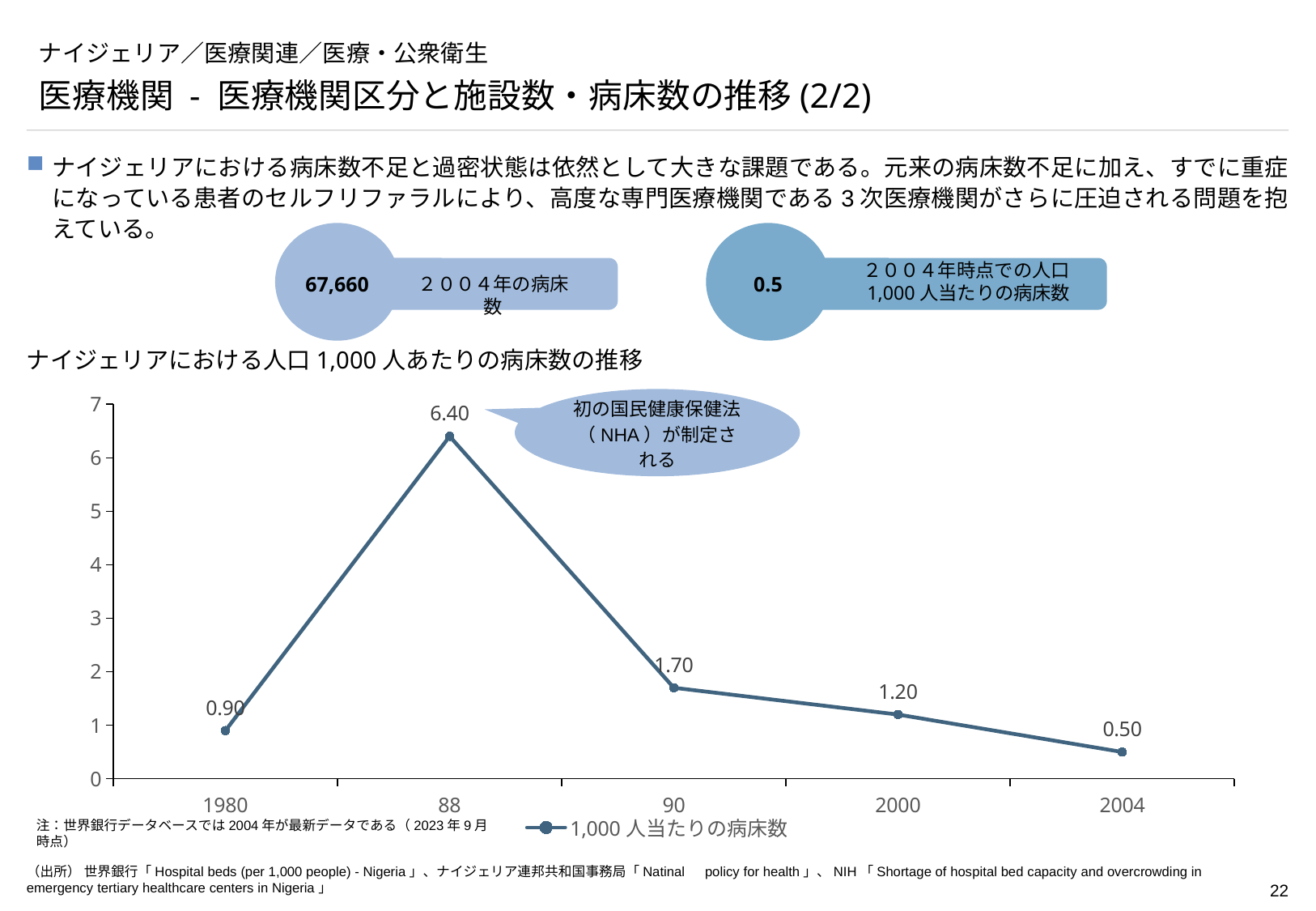
What is the difference between the values for 88 and 90? 4.70 Is the value for 90 greater or less than 2? less What is the value for 2004 in the chart? 0.50 Which year has the highest value in the chart? 88 Which year has the lowest value in the chart? 2004 What is the value for 88 in the chart? 6.40 How many data points are plotted in the chart? 5 What kind of chart is shown on the slide? line chart Do the values rise or fall from 88 to 2004? fall What is the value for 1980 in the chart? 0.90 What is the difference between the values for 2000 and 2004? 0.70 Which is larger, the value for 1980 or the value for 2000? 2000